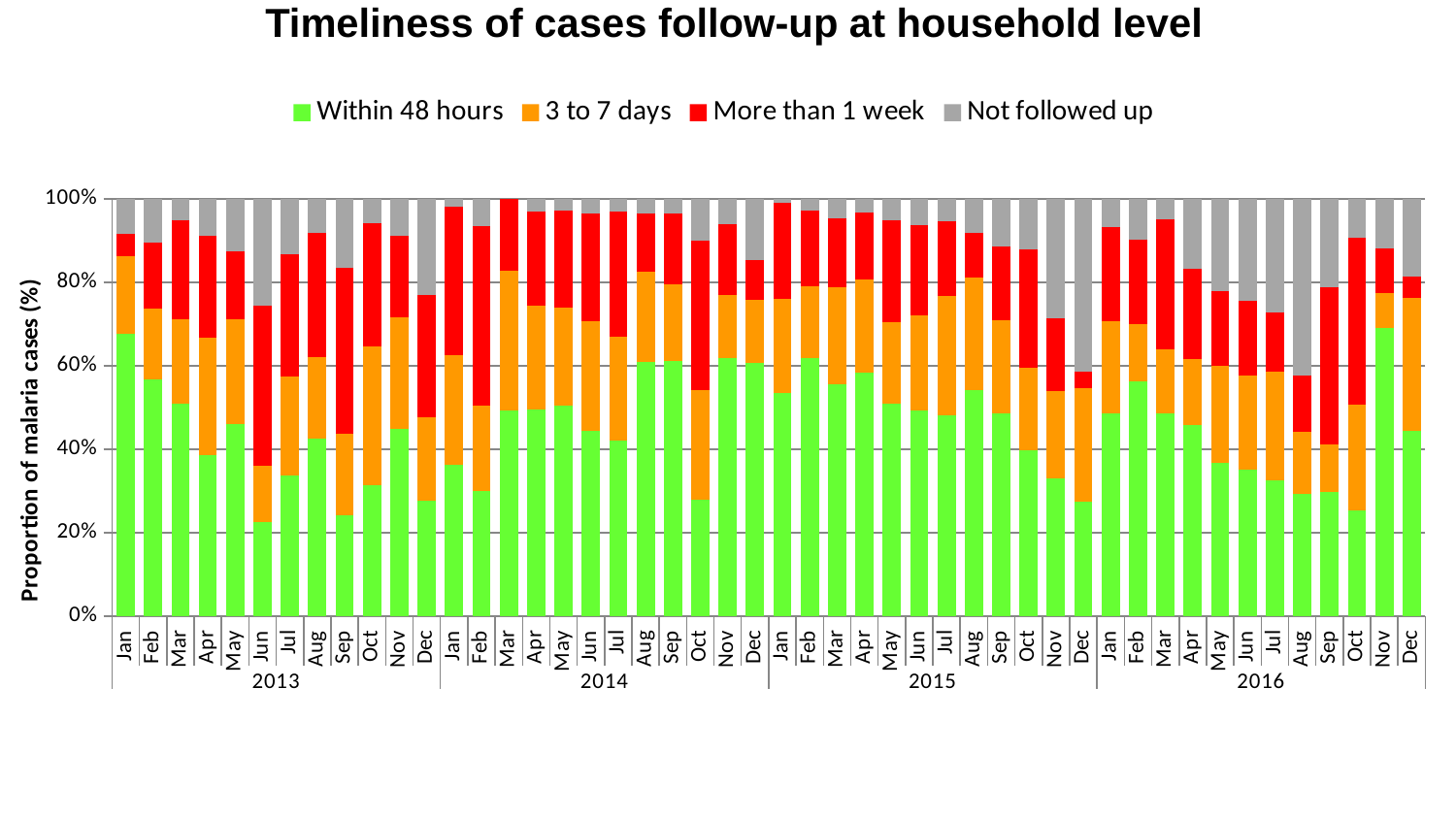
What kind of chart is shown on the slide? Stacked bar chart How many series does the legend list? 4 Is the 'Within 48 hours' value for Dec 2015 greater or less than 40%? less How many years are covered on the x axis of the chart? 4 What is the title of the chart? Timeliness of cases follow-up at household level How many monthly bars are plotted in the chart? 48 Which colour represents the 'Not followed up' series in the chart? Grey From Jan 2013 to Jun 2013, does the 'Within 48 hours' share rise or fall? Fall Which month has the larger 'Within 48 hours' share, Jan 2013 or Jun 2013? Jan 2013 Is the 'Within 48 hours' value for Nov 2016 greater or less than 60%? greater Is the 'Within 48 hours' value for Jan 2013 greater or less than 60%? greater